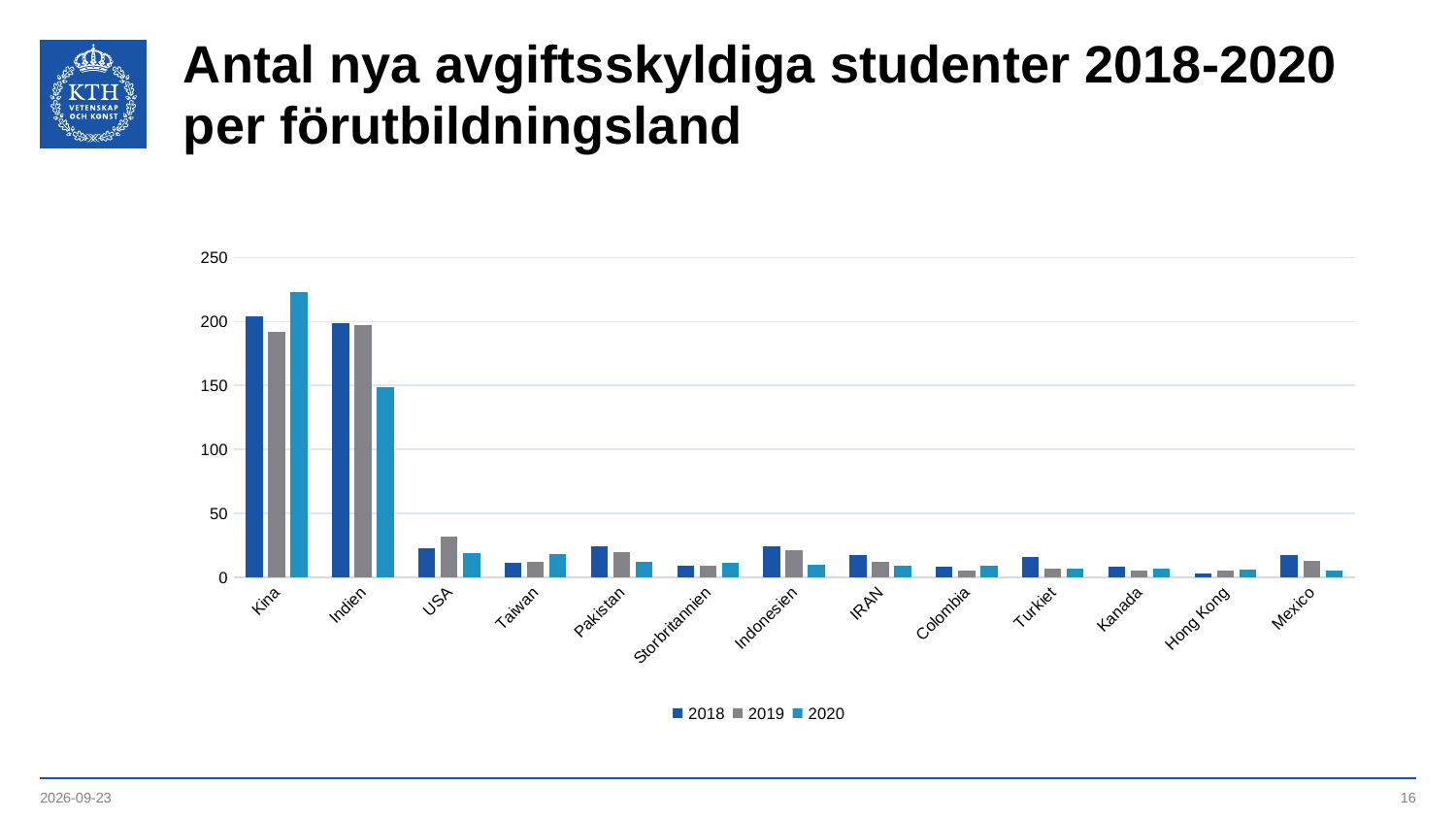
Is the value for Kina in 2019 greater or less than 200? less Which is larger for 2020: Kina or Indien? Kina Which country has the lowest value for 2018? Hong Kong What kind of chart is shown on the slide? bar chart How many countries (categories) are shown on the x axis? 13 Is the value for Indien in 2020 greater or less than 100? greater Which years are listed in the legend? 2018, 2019, 2020 Is the value for Kina in 2020 greater or less than 200? greater How many series does the legend list? 3 Do the values for Indien rise or fall from 2018 to 2020? fall Which country has the highest bar in the chart? Kina